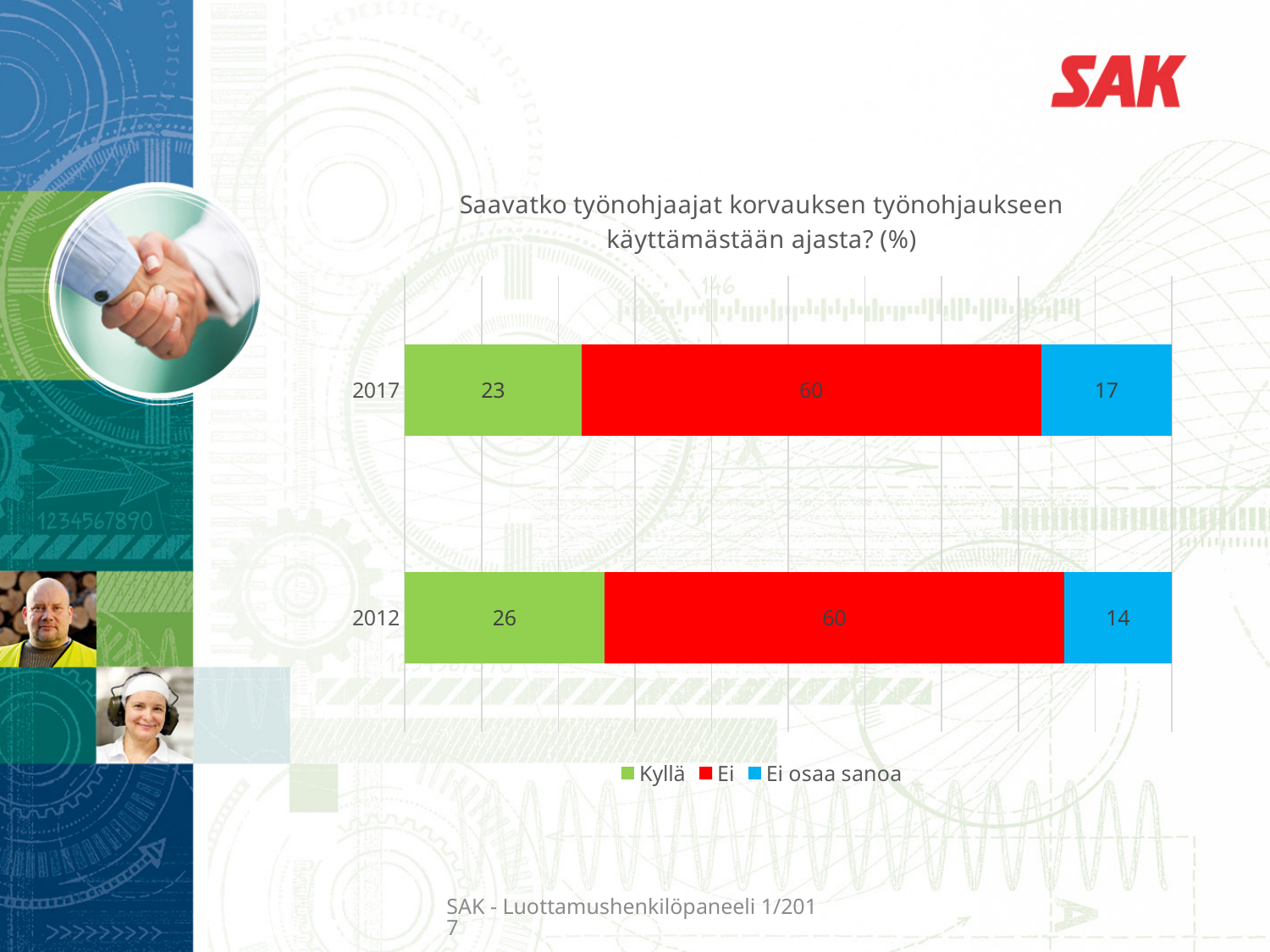
What is the value for "Kyllä" in 2017? 23 Which year has the higher value for "Kyllä", 2017 or 2012? 2012 What kind of chart is shown on the slide? Stacked bar chart What is the value for "Ei" in 2017? 60 How many series does the legend list? 3 What is the difference between the "Kyllä" values for 2012 and 2017? 3 What is the difference between the "Ei osaa sanoa" values for 2017 and 2012? 3 How many categories (years) are shown on the chart? 2 What is the value for "Ei osaa sanoa" in 2012? 14 Which legend entry is shown in red? Ei What is the total of the stacked bar for 2017? 100 What is the value for "Kyllä" in 2012? 26